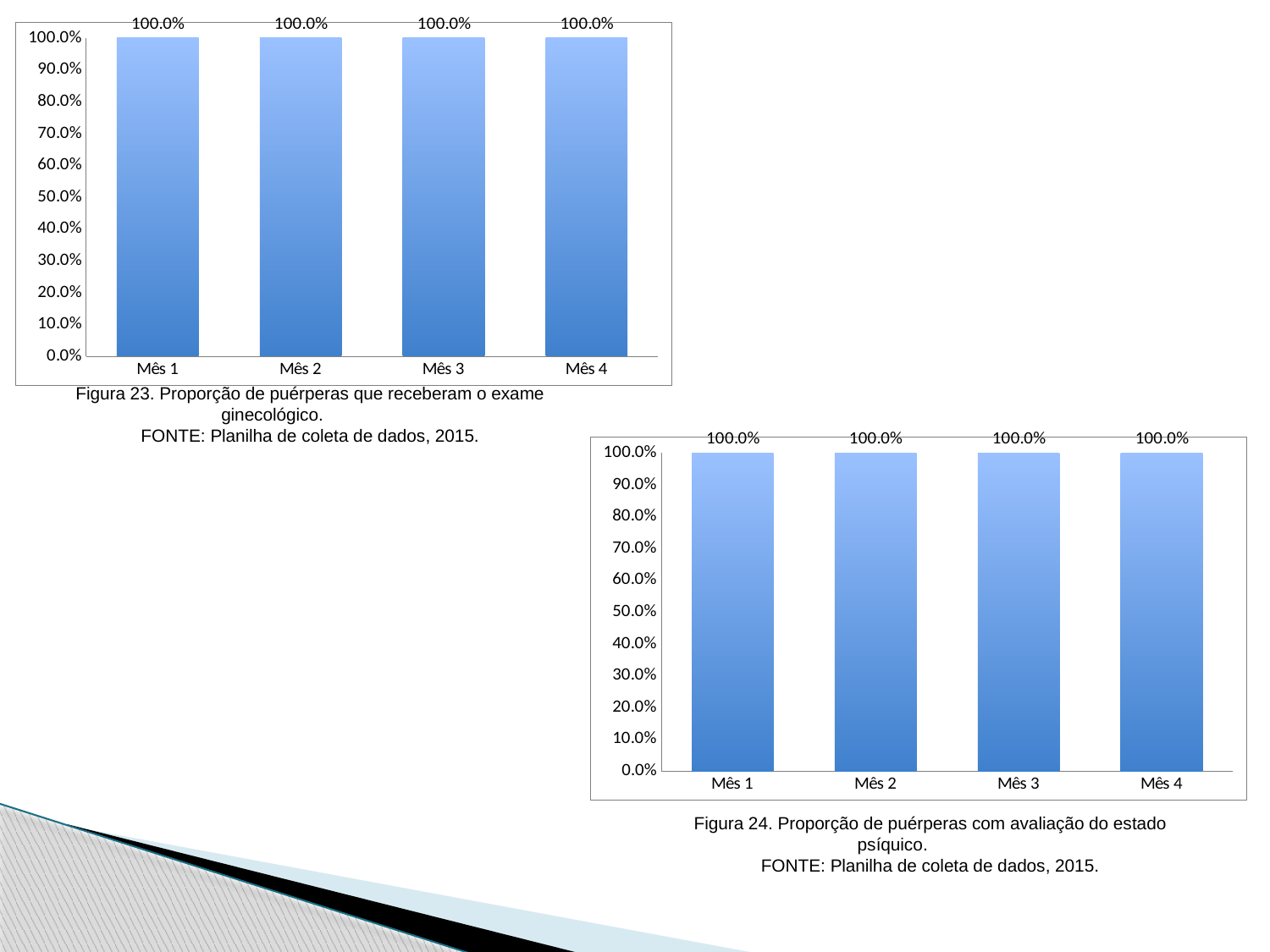
In the top-left chart (Figura 23), what is the value for Mês 4? 100.0% In the bottom-right chart (Figura 24), do the values rise, fall, or stay the same from Mês 1 to Mês 4? Stay the same In the bottom-right chart (Figura 24), what is the difference between the values for Mês 4 and Mês 1? 0.0% What kind of chart is the top-left chart (Figura 23)? Bar chart In the top-left chart (Figura 23), is the value for Mês 2 greater or less than 50.0%? greater How many categories are shown on the x axis of the top-left chart (Figura 23)? 4 How many bars are plotted in the bottom-right chart (Figura 24)? 4 In the top-left chart (Figura 23), what is the difference between the values for Mês 1 and Mês 3? 0.0% In the bottom-right chart (Figura 24), what is the value for Mês 3? 100.0% In the bottom-right chart (Figura 24), what is the value for Mês 2? 100.0% In the top-left chart (Figura 23), what is the value for Mês 1? 100.0% According to the caption, what does the bottom-right chart (Figura 24) show the proportion of? Puérperas com avaliação do estado psíquico